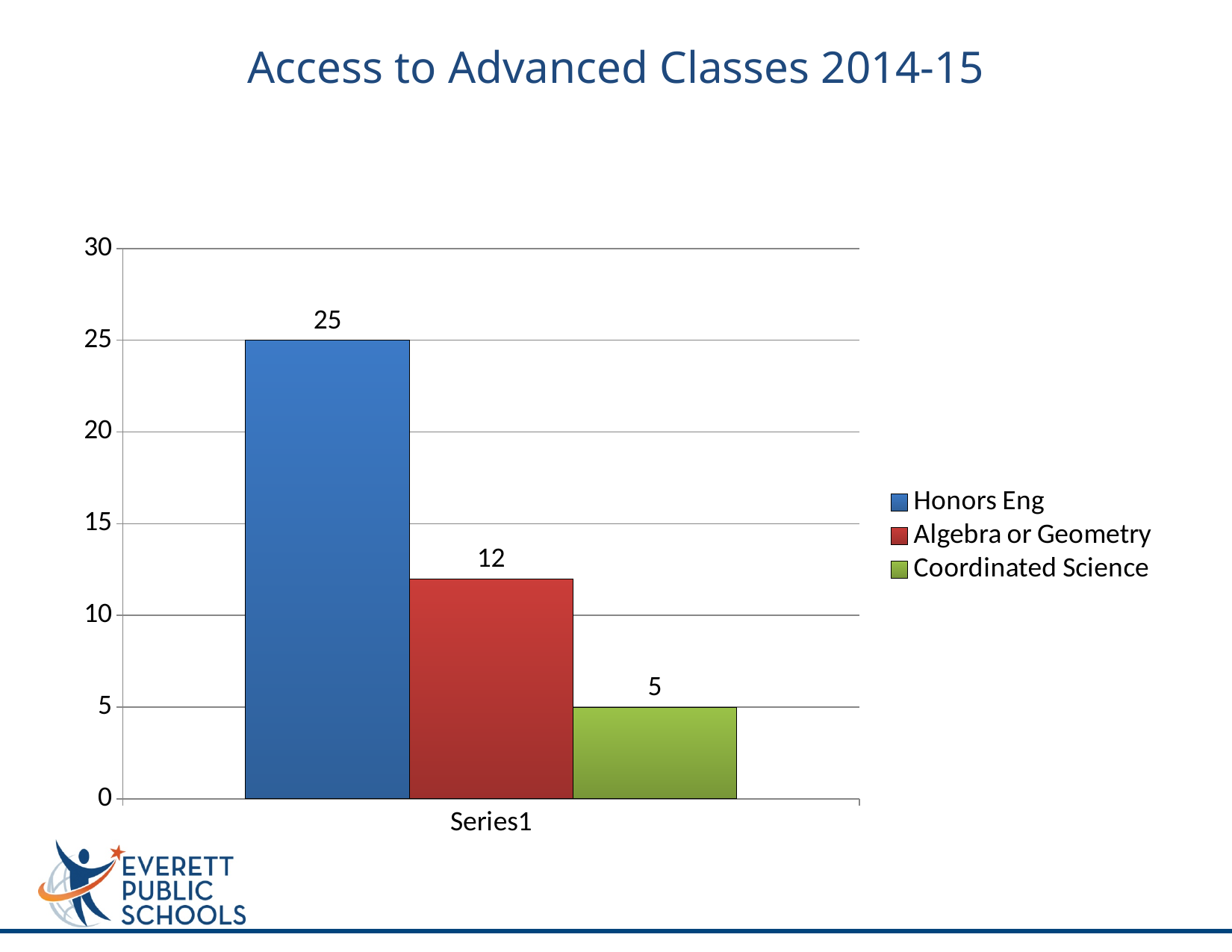
Which series has the lowest value? Coordinated Science Is the value for Honors Eng greater or less than 20? greater What is the difference between the values for Honors Eng and Algebra or Geometry? 13 What is the title of the chart? Access to Advanced Classes 2014-15 What is the value for Coordinated Science? 5 What kind of chart is shown on the slide? Bar chart What is the value for Honors Eng? 25 What is the value for Algebra or Geometry? 12 What is the difference between the values for Algebra or Geometry and Coordinated Science? 7 Which is larger, the value for Algebra or Geometry or the value for Coordinated Science? Algebra or Geometry How many series does the legend list? 3 Which series has the highest value? Honors Eng